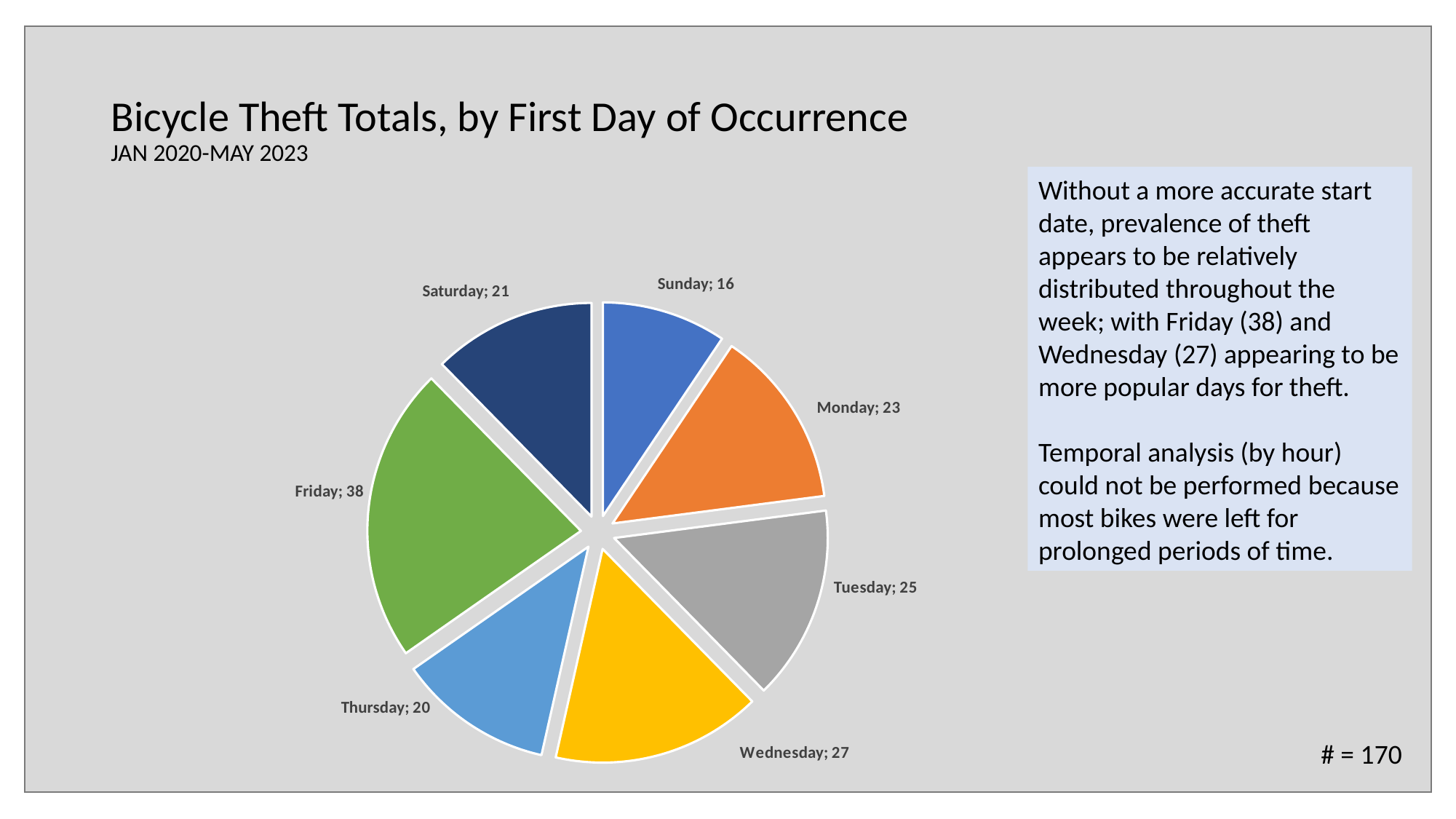
What is the title of the chart? Bicycle Theft Totals, by First Day of Occurrence Which day has the highest bicycle theft total? Friday What is the value for Wednesday in the pie chart? 27 Which is larger, the value for Monday or the value for Saturday? Monday What is the difference between the values for Tuesday and Thursday? 5 How many categories (days) are shown in the pie chart? 7 What is the value for Sunday in the pie chart? 16 What is the difference between the values for Friday and Wednesday? 11 What kind of chart is shown on the slide? Pie chart Which day has the lowest bicycle theft total? Sunday What is the value for Friday in the pie chart? 38 What time period does the chart subtitle cover? JAN 2020-MAY 2023